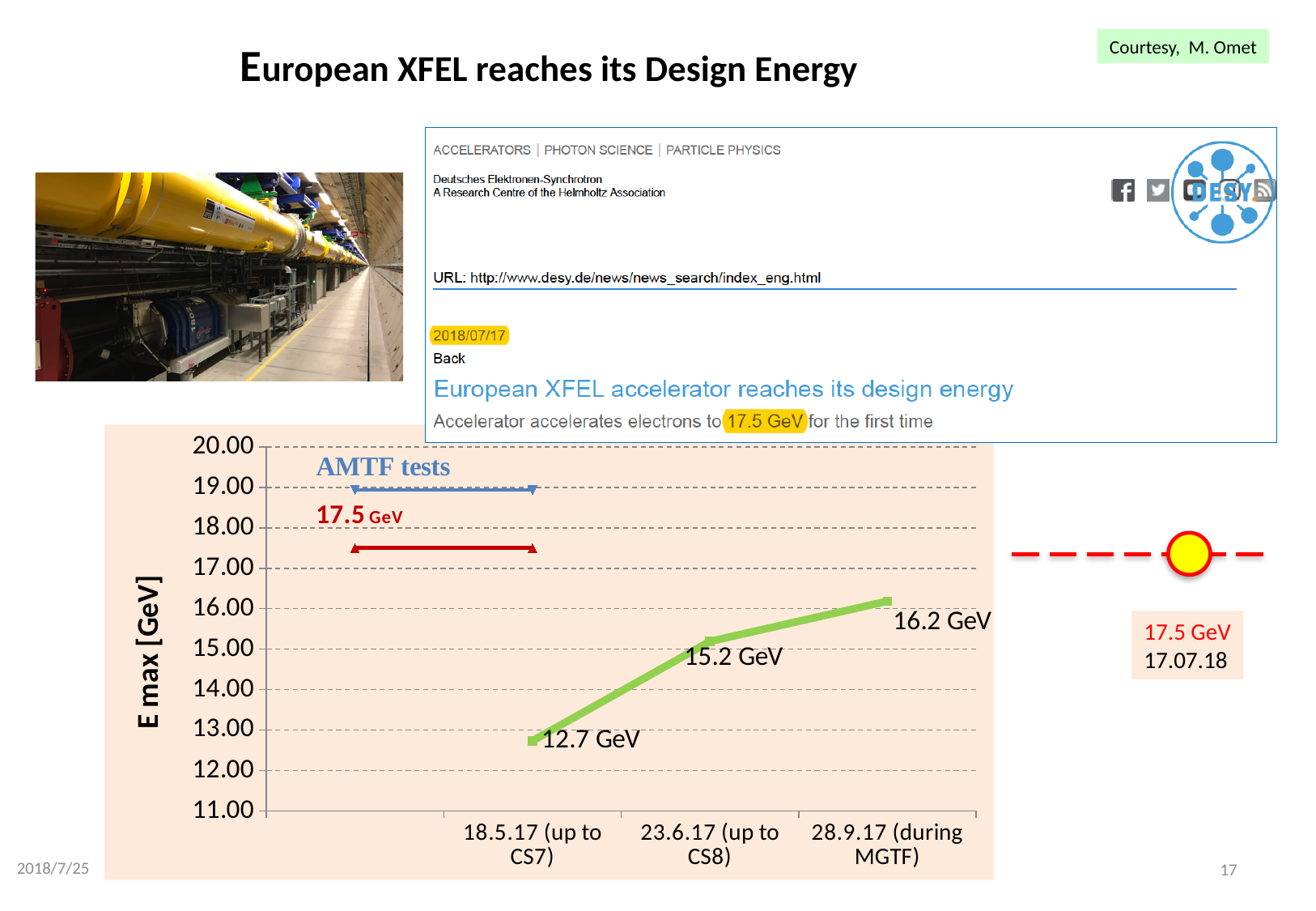
Which date has the highest E max value? 28.9.17 (during MGTF) What is the difference in E max between 28.9.17 (during MGTF) and 23.6.17 (up to CS8)? 1.0 GeV What is the label of the y axis of the chart? E max [GeV] What is the E max value for 28.9.17 (during MGTF)? 16.2 GeV Do the E max values rise or fall from left to right along the x axis? rise What type of chart is shown on the slide? line chart Which date has the lowest E max value? 18.5.17 (up to CS7) Which is larger, the E max for 23.6.17 (up to CS8) or for 18.5.17 (up to CS7)? 23.6.17 (up to CS8) What is the difference in E max between 23.6.17 (up to CS8) and 18.5.17 (up to CS7)? 2.5 GeV What is the E max value for 18.5.17 (up to CS7)? 12.7 GeV What is the E max value for 23.6.17 (up to CS8)? 15.2 GeV How many data points are plotted on the line? 3